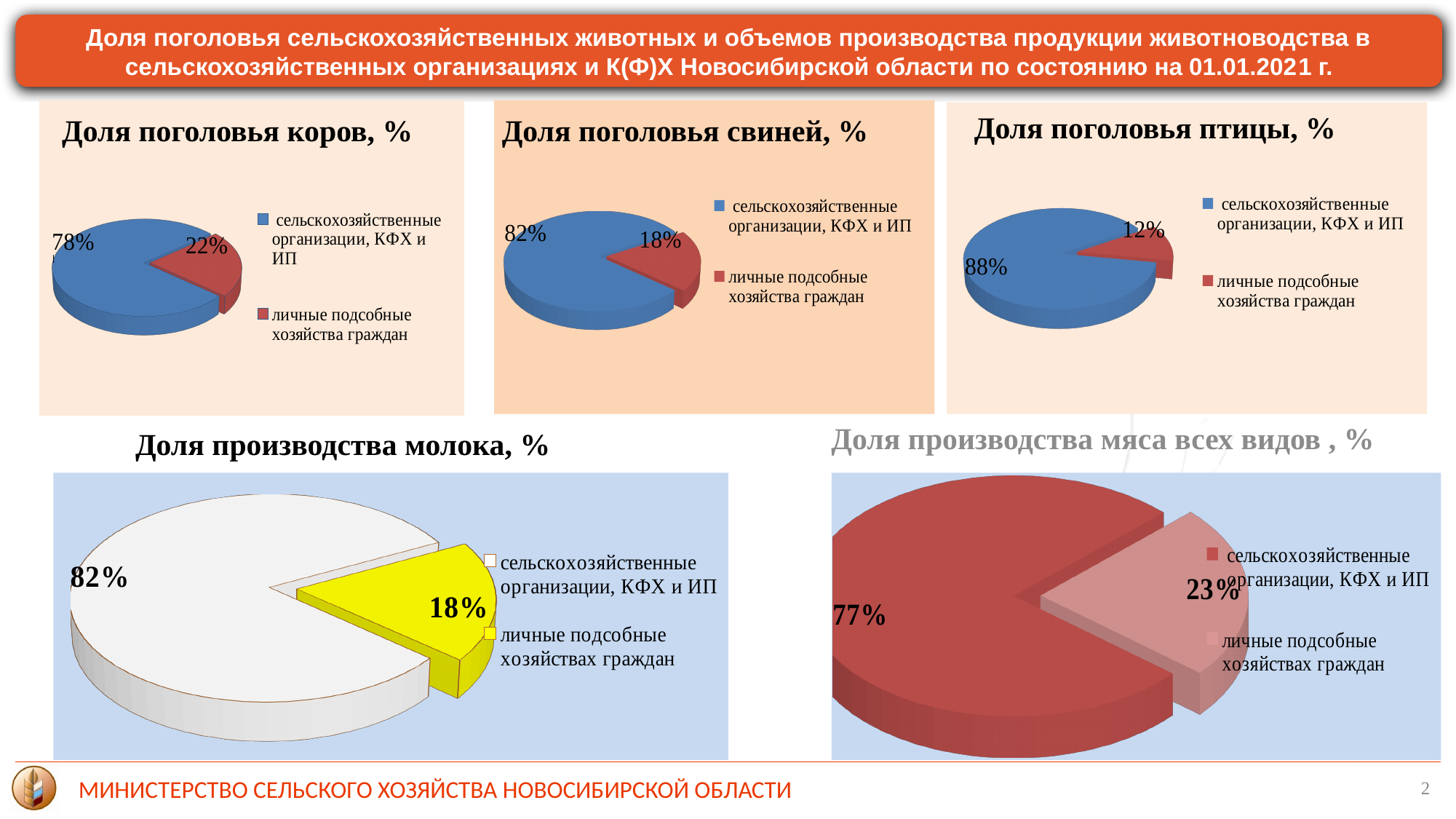
What type of chart is "Доля производства молока, %"? pie chart In the chart "Доля поголовья коров, %", what share is shown for сельскохозяйственные организации, КФХ и ИП? 78% How many pie charts are shown on the slide? 5 In the chart "Доля производства молока, %", what share is shown for личные подсобные хозяйствах граждан? 18% In the chart "Доля поголовья коров, %", what share is shown for личные подсобные хозяйства граждан? 22% In the chart "Доля производства мяса всех видов, %", which category has the largest slice? сельскохозяйственные организации, КФХ и ИП Which is larger: the share of личные подсобные хозяйства граждан in "Доля поголовья коров, %" or in "Доля поголовья птицы, %"? Доля поголовья коров, % In the chart "Доля поголовья свиней, %", what share is shown for личные подсобные хозяйства граждан? 18% In the chart "Доля поголовья птицы, %", what share is shown for личные подсобные хозяйства граждан? 12% In the chart "Доля поголовья птицы, %", what share is shown for сельскохозяйственные организации, КФХ и ИП? 88% In the chart "Доля поголовья свиней, %", what is the difference between the two slices? 64% In the chart "Доля производства мяса всех видов, %", what share is shown for сельскохозяйственные организации, КФХ и ИП? 77%